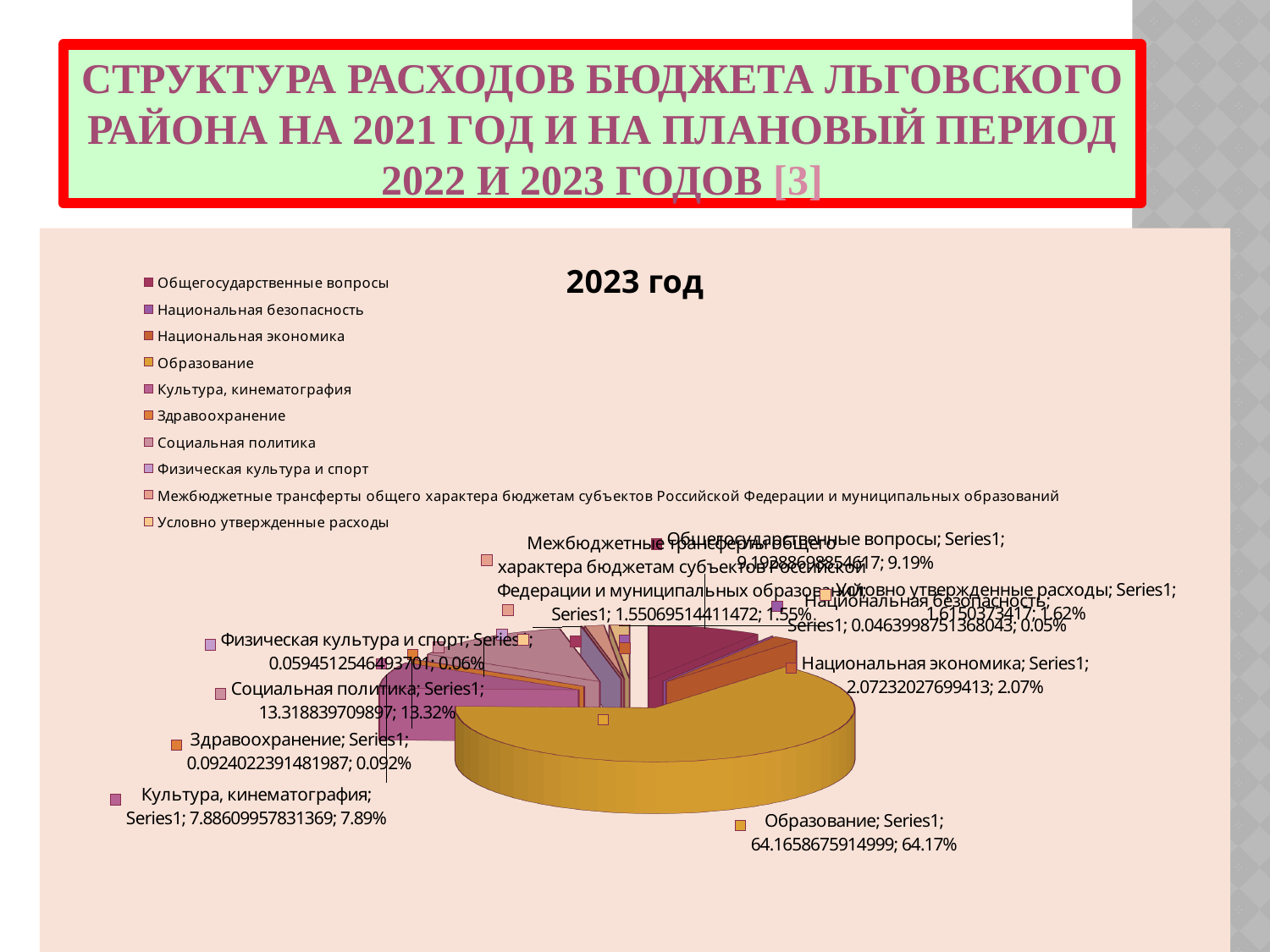
Which category has the largest share of the pie? Образование What percentage share does Культура, кинематография have in the chart? 7.89% What is the title of the chart? 2023 год What kind of chart is shown on the slide? pie chart What percentage share does Социальная политика have in the chart? 13.32% Which has a larger share: Социальная политика or Общегосударственные вопросы? Социальная политика What percentage share does Здравоохранение have in the chart? 0.092% What percentage share does Образование have in the chart? 64.17% Which category has the smallest share of the pie? Национальная безопасность What percentage share does Национальная экономика have in the chart? 2.07% What is the difference in percentage points between the shares of Образование (64.17%) and Социальная политика (13.32%)? 50.85 How many categories does the legend of the chart list? 10